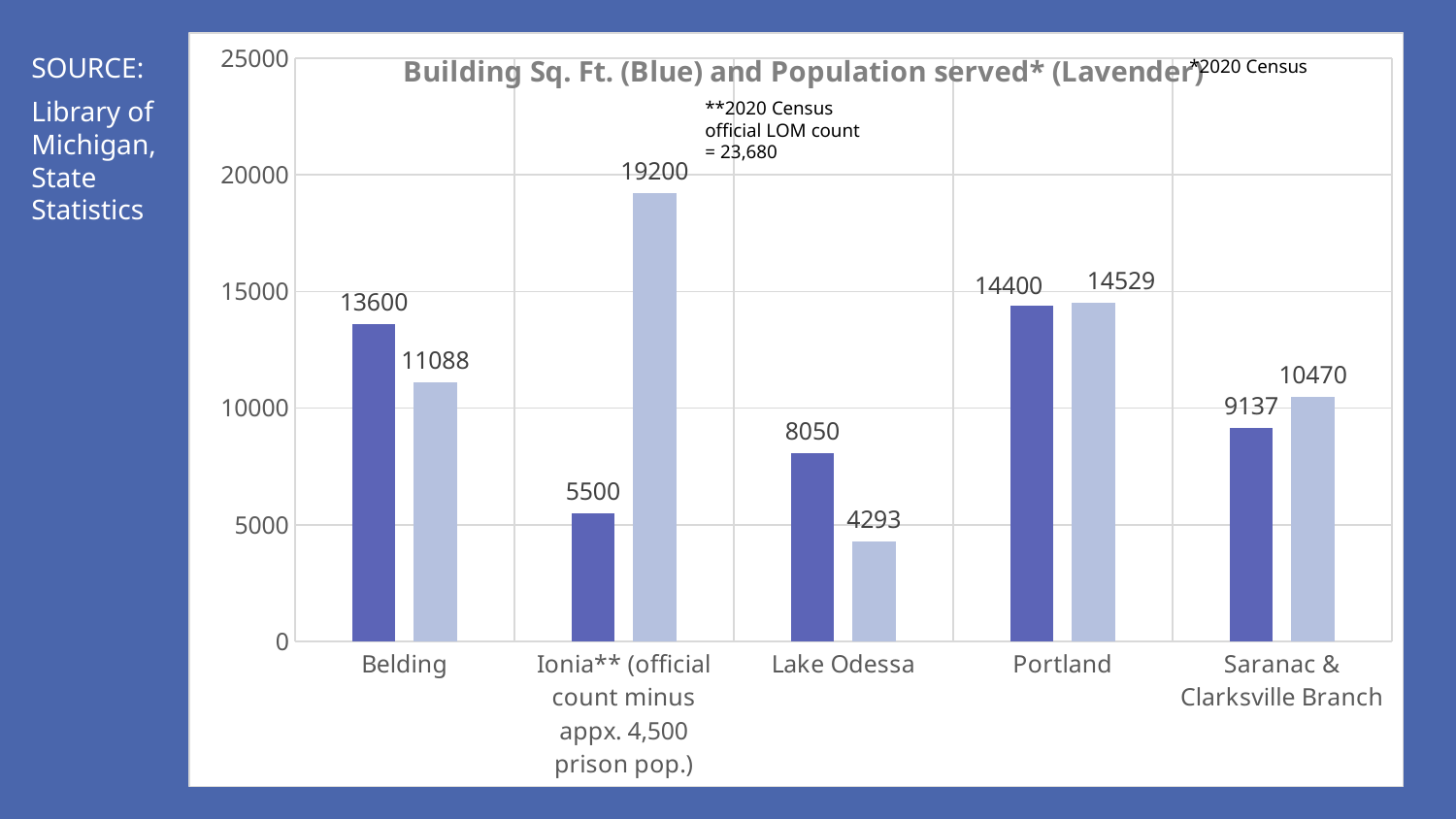
What is the population served for Saranac & Clarksville Branch? 10470 What is the difference between the population served and the building square footage for Ionia? 13700 What is the difference between the building square footage of Portland and Belding? 800 Which library has the smallest population served (lavender bars)? Lake Odessa Which library has the largest building square footage (blue bars)? Portland Which is larger for Belding: building square footage or population served? Building square footage What is the building square footage for Belding? 13600 How many libraries are shown on the x axis? 5 What is the population served for Lake Odessa? 4293 What type of chart is shown on the slide? Bar chart Is the population served for Ionia greater or less than 15000? greater Which library has the smallest building square footage (blue bars)? Ionia